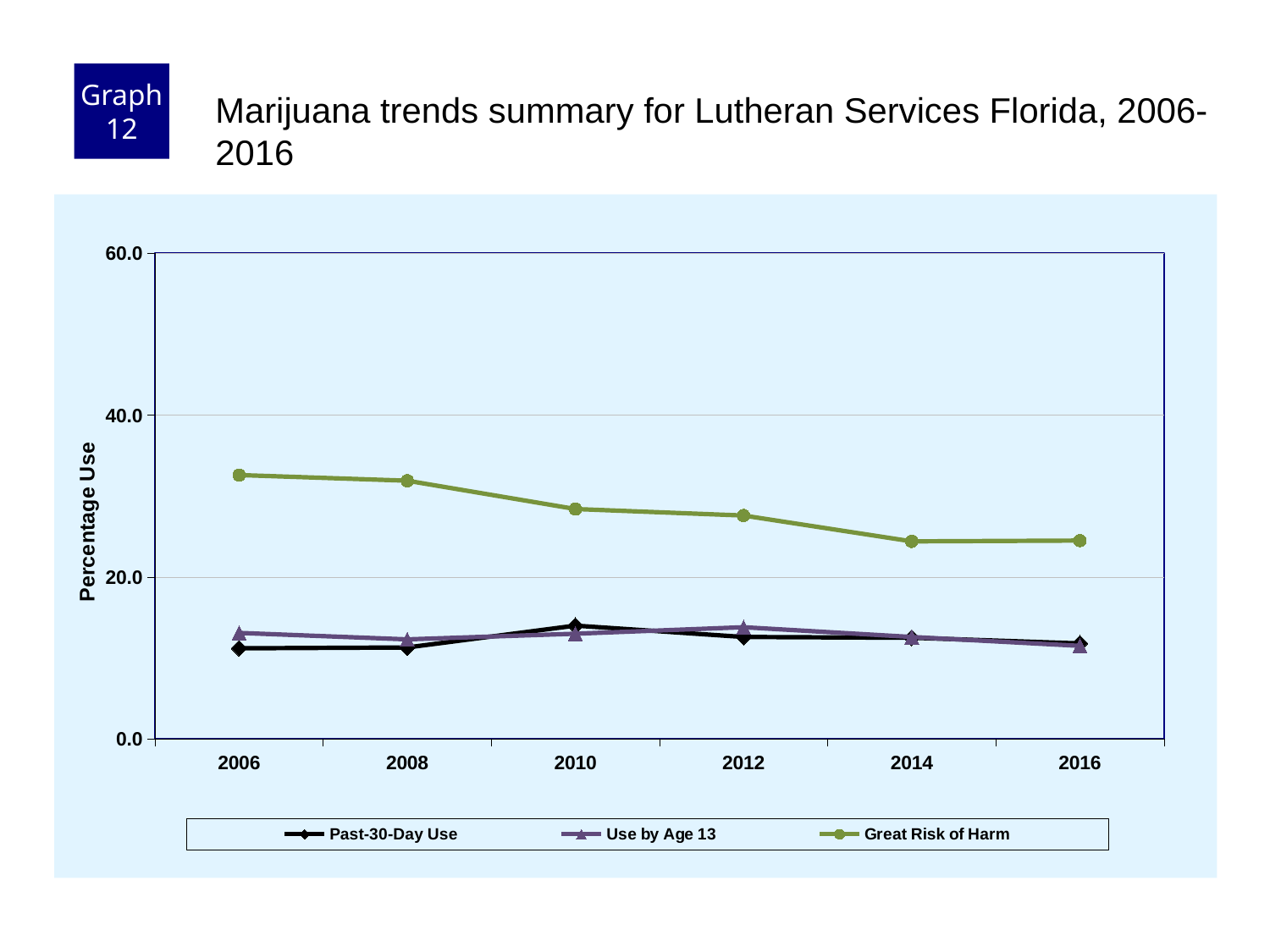
Is the value for Past-30-Day Use in 2010 greater or less than 20.0? less What is the label on the y axis? Percentage Use How many years are plotted along the x axis? 6 Which series has the highest values across all years? Great Risk of Harm Is the value for Great Risk of Harm in 2006 greater or less than 40.0? less What kind of chart is shown on the slide? Line chart Does the Great Risk of Harm line rise or fall from 2006 to 2016? Fall How many series does the legend list? 3 Is the value for Great Risk of Harm in 2016 greater or less than 20.0? greater In 2010, which is larger: Great Risk of Harm or Past-30-Day Use? Great Risk of Harm What is the title of the slide's chart? Marijuana trends summary for Lutheran Services Florida, 2006-2016